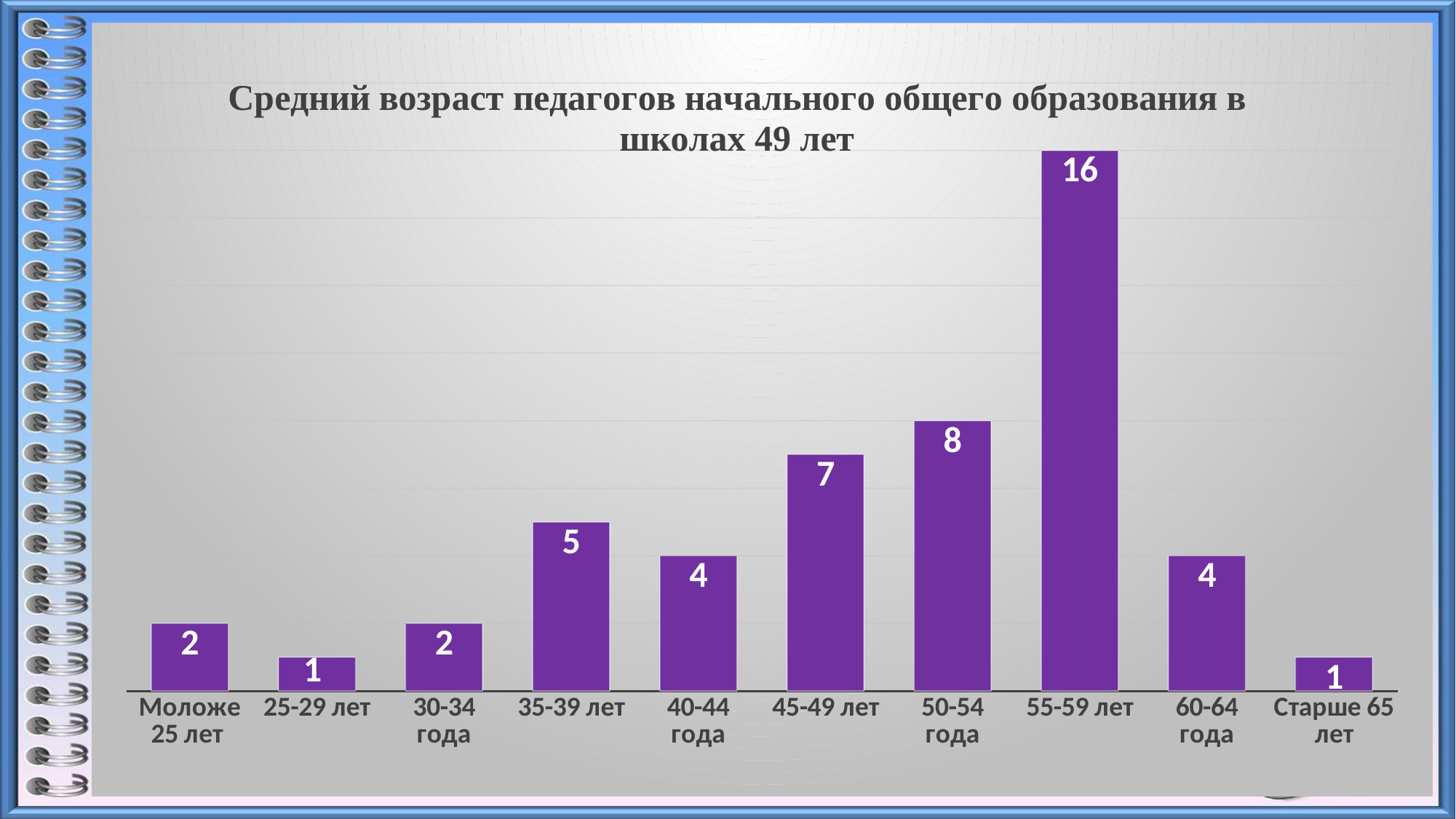
What is the difference between the values for 35-39 лет and 25-29 лет? 4 What is the title of the chart? Средний возраст педагогов начального общего образования в школах 49 лет What is the value for the 55-59 лет category? 16 Which is larger, the value for 30-34 года or the value for 35-39 лет? 35-39 лет What is the value for the 45-49 лет category? 7 Which is larger, the value for 40-44 года or the value for 50-54 года? 50-54 года What colour are the bars in the chart? Purple What is the value for the Моложе 25 лет category? 2 How many age categories are shown on the x axis? 10 What is the difference between the values for 55-59 лет and 50-54 года? 8 What kind of chart is shown on the slide? Bar chart Which age category has the highest value? 55-59 лет